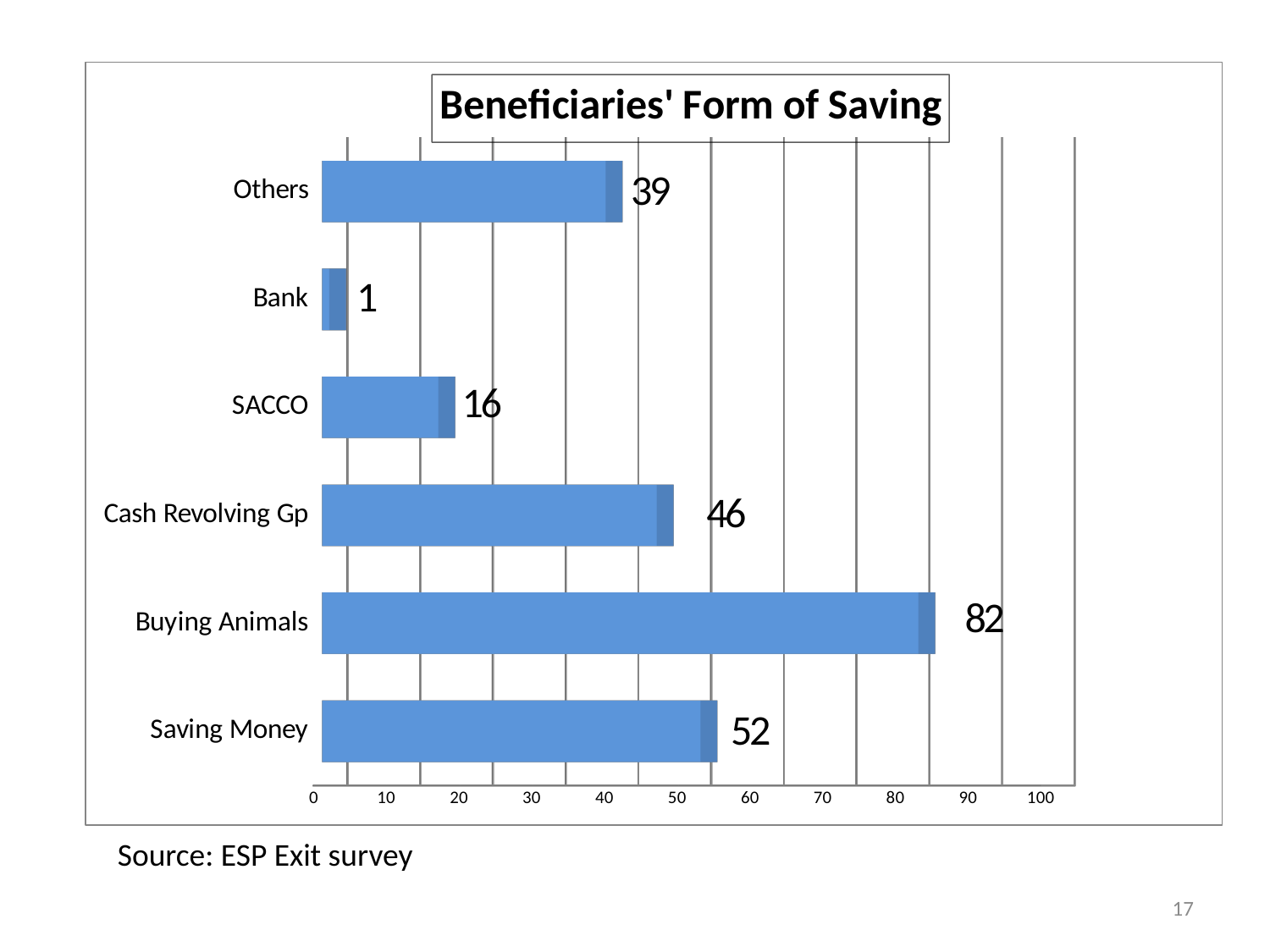
Which form of saving has the lowest value? Bank What is the difference between the values for Cash Revolving Gp and Others? 7 What is the difference between the values for Buying Animals and Saving Money? 30 How many categories are shown in the chart? 6 What kind of chart is shown on the slide? bar chart Which form of saving has the highest value? Buying Animals What is the title of the chart? Beneficiaries' Form of Saving What is the value for SACCO? 16 Is the value for Others greater or less than 30? greater Which is larger, the value for Saving Money or the value for Others? Saving Money What is the value for Buying Animals? 82 What is the value for Cash Revolving Gp? 46